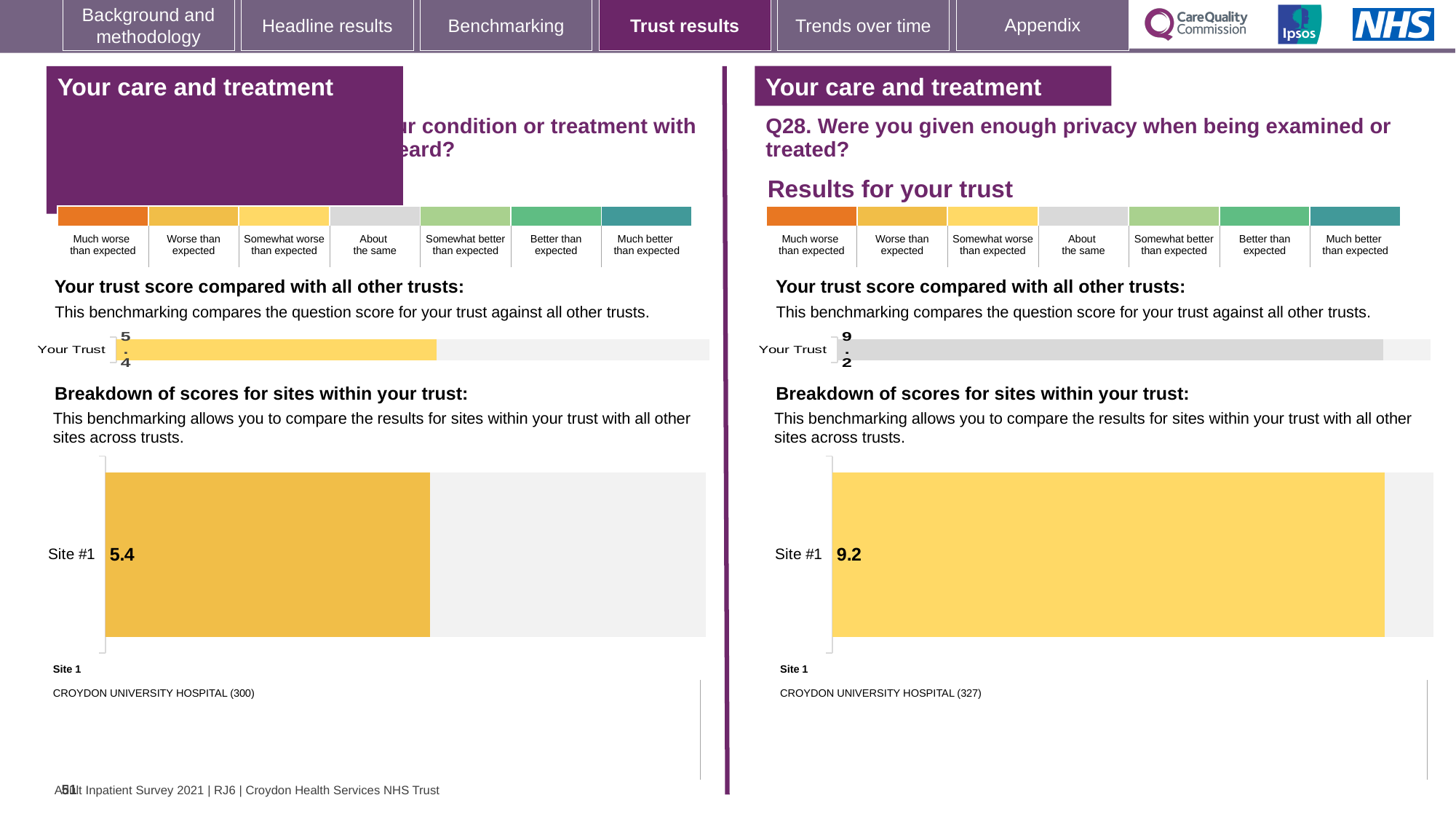
What is the difference between the Site #1 score on the right-hand Q28 breakdown chart and the Site #1 score on the left-hand breakdown chart? 3.8 On the right-hand chart for Q28, what is the score shown for Your Trust? 9.2 Which is larger: the Site #1 score on the left-hand breakdown chart or the Site #1 score on the right-hand Q28 breakdown chart? Right-hand Q28 chart On the left-hand 'Your trust score compared with all other trusts' chart, what is the score shown for Your Trust? 5.4 What colour is the Site #1 bar in the right-hand Q28 breakdown chart? Yellow How many sites are shown in the right-hand Q28 'Breakdown of scores for sites within your trust' chart? 1 What kind of chart is used for the 'Breakdown of scores for sites within your trust' on the right-hand side? Bar chart On the left-hand 'Breakdown of scores for sites within your trust' chart, what is the score for Site #1? 5.4 What is the name of Site 1 listed below the right-hand Q28 breakdown chart? CROYDON UNIVERSITY HOSPITAL (327) On the right-hand 'Breakdown of scores for sites within your trust' chart for Q28, what is the score for Site #1? 9.2 How many sites are shown in the left-hand 'Breakdown of scores for sites within your trust' chart? 1